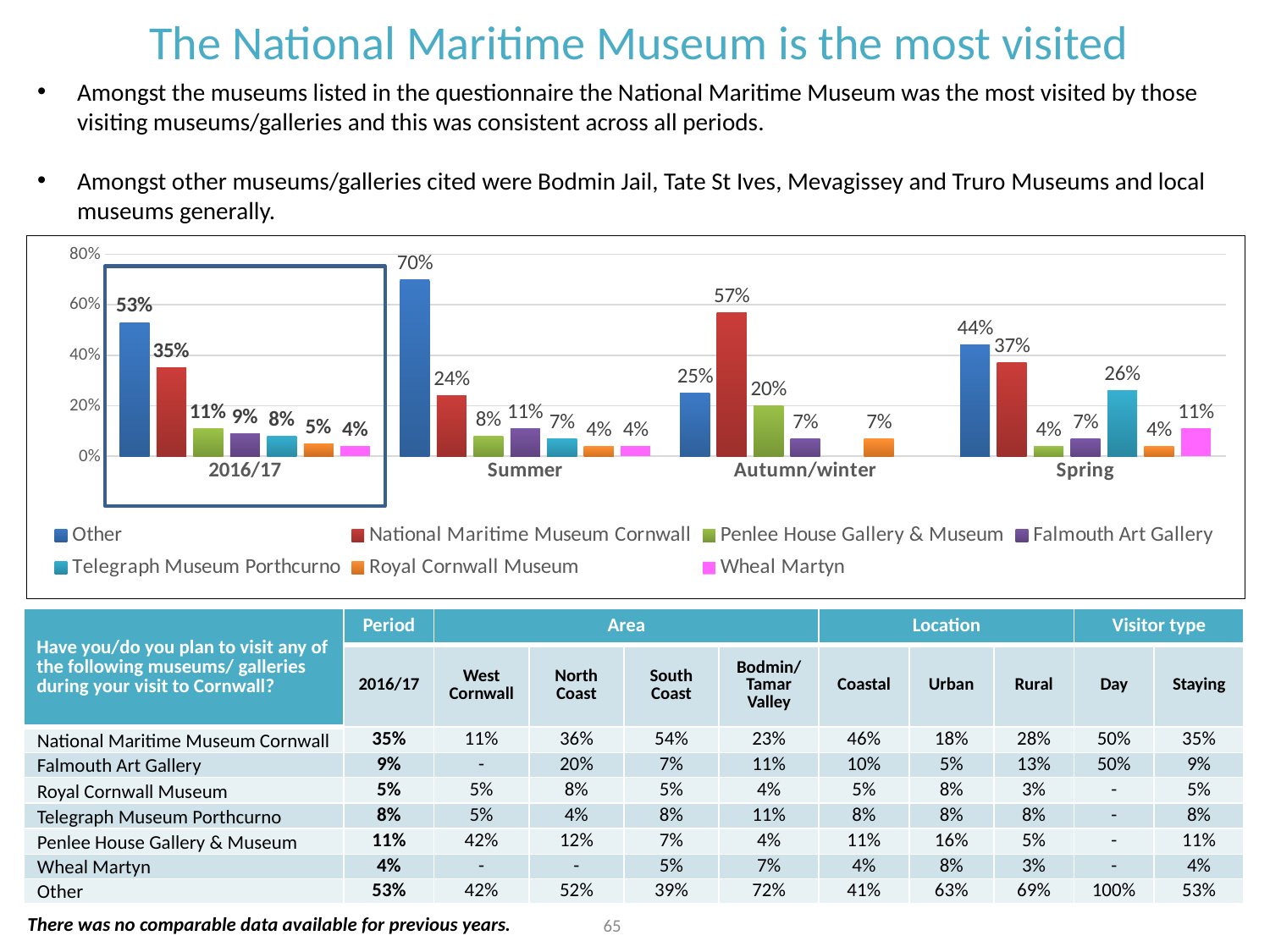
What is the difference between the Other value and the National Maritime Museum Cornwall value in the 2016/17 group? 18 percentage points What is the value for Telegraph Museum Porthcurno in the Spring group? 26% What kind of chart is shown on the slide? Bar chart What is the value for Penlee House Gallery & Museum in the Autumn/winter group? 20% What is the value for Other in the Summer group? 70% How many category groups are shown on the x axis of the chart? 4 Is the value for National Maritime Museum Cornwall in the Autumn/winter group greater or less than 40%? greater In the Autumn/winter group, which series has the highest value? National Maritime Museum Cornwall What is the value for National Maritime Museum Cornwall in the 2016/17 group? 35% How many series does the chart legend list? 7 In the Spring group, which series has the lowest value? Penlee House Gallery & Museum and Royal Cornwall Museum (both 4%) Which is larger in the Spring group: Other or National Maritime Museum Cornwall? Other